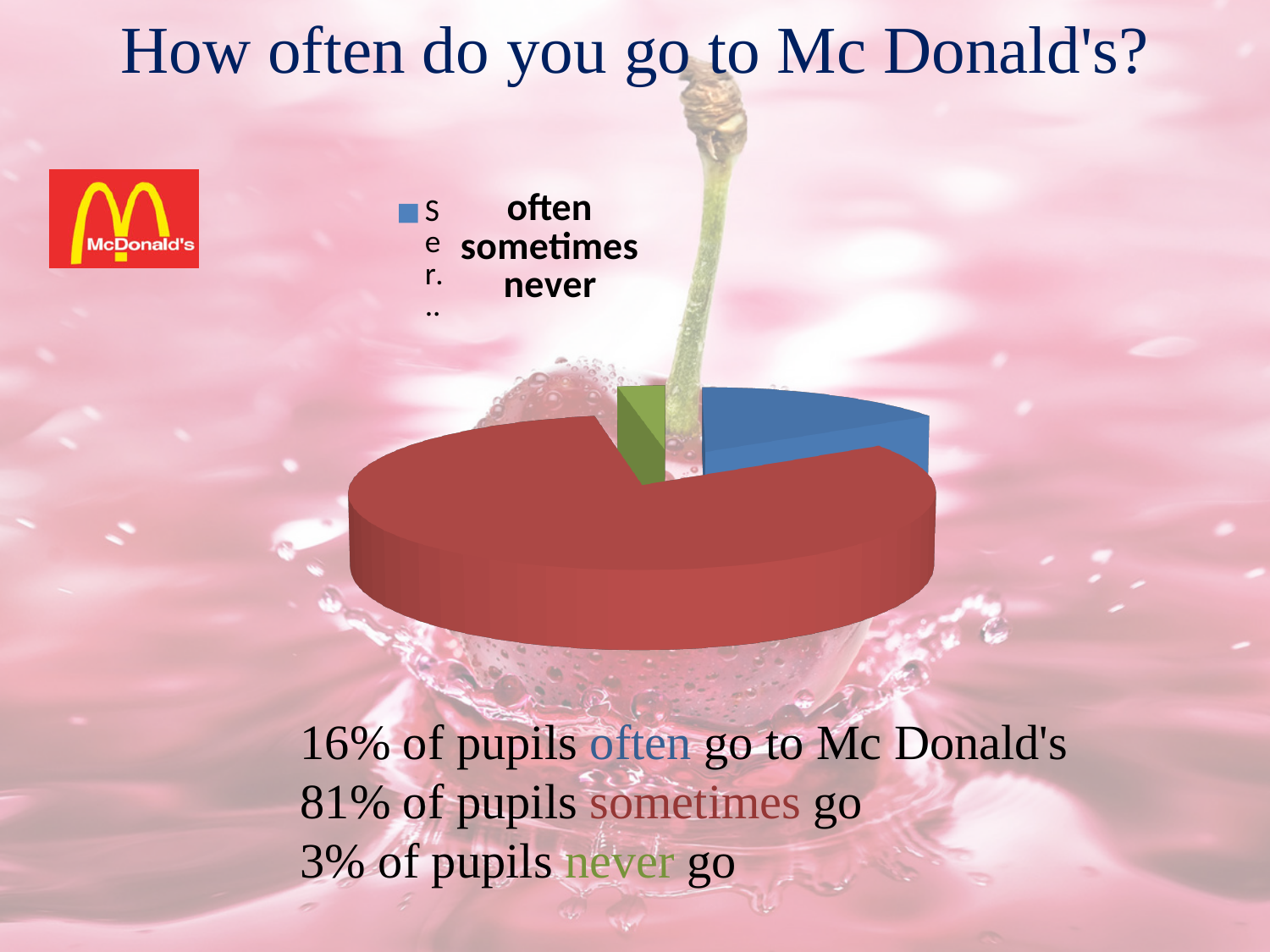
What percentage of pupils never go to Mc Donald's? 3% What is the difference in percentage points between often and never? 13 Which category has the largest slice of the pie? sometimes What colour is the slice representing pupils who sometimes go? red What kind of chart is shown on the slide? pie chart Which is larger, the share for often or the share for never? often What percentage of pupils sometimes go to Mc Donald's? 81% What is the difference in percentage points between sometimes and often? 65 What percentage of pupils often go to Mc Donald's? 16% What colour is the slice representing pupils who often go? blue How many slices does the pie chart have? 3 Which category has the smallest slice of the pie? never